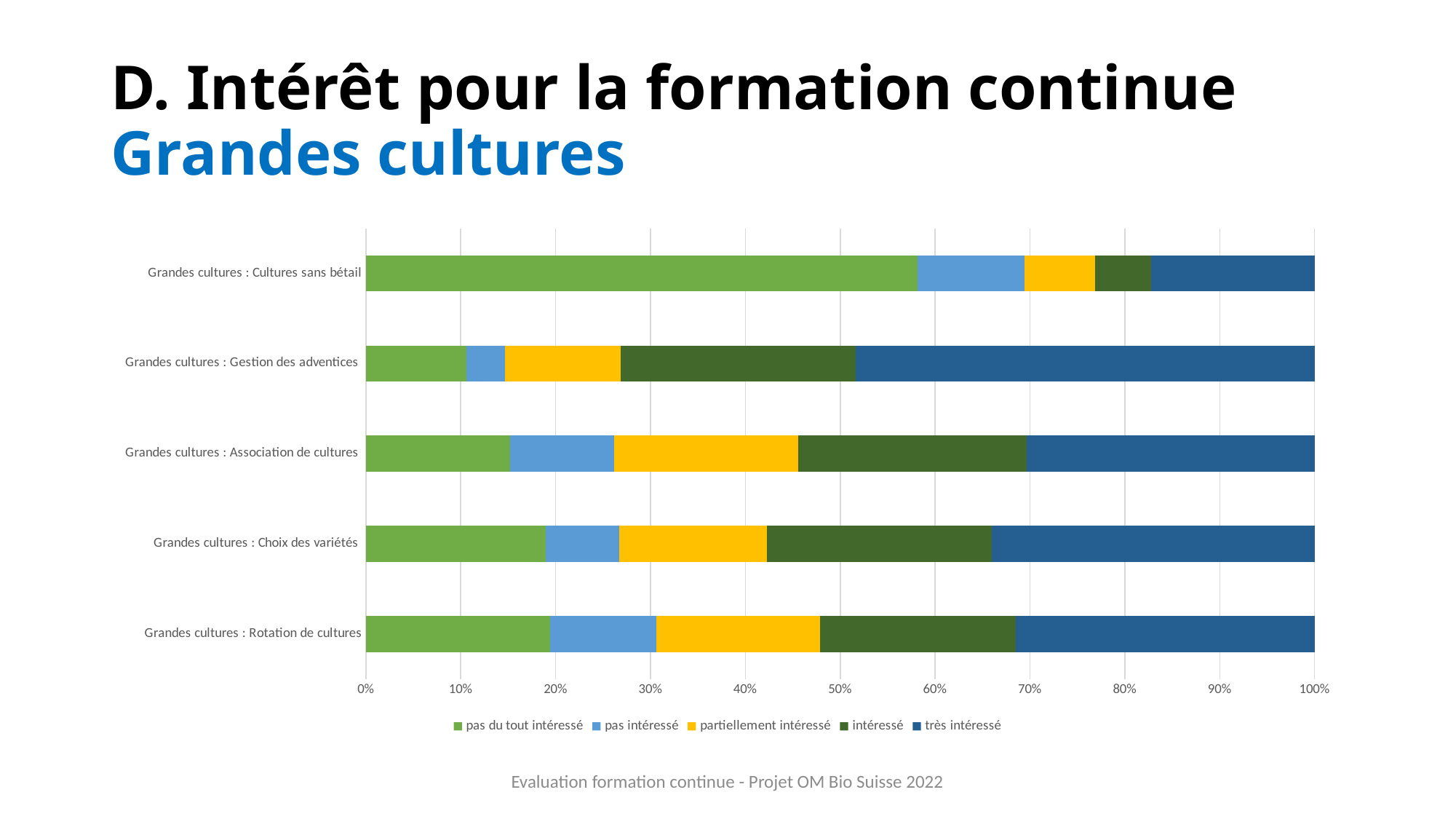
Is the 'pas du tout intéressé' share for Grandes cultures : Gestion des adventices greater or less than 20%? less What is the total of each stacked bar, as shown by the x axis? 100% Which category has the smallest 'très intéressé' segment? Grandes cultures : Cultures sans bétail What kind of chart is shown on the slide? Stacked bar chart Which category has the smallest 'pas du tout intéressé' segment? Grandes cultures : Gestion des adventices Which category has the largest 'pas du tout intéressé' segment? Grandes cultures : Cultures sans bétail Which category has the largest 'très intéressé' segment? Grandes cultures : Gestion des adventices Is the 'pas du tout intéressé' share for Grandes cultures : Cultures sans bétail greater or less than 50%? greater How many categories (bars) does the chart show? 5 What is the first entry in the chart legend? pas du tout intéressé Which is larger: the 'pas du tout intéressé' segment for Cultures sans bétail or for Rotation de cultures? Cultures sans bétail How many series does the legend list? 5